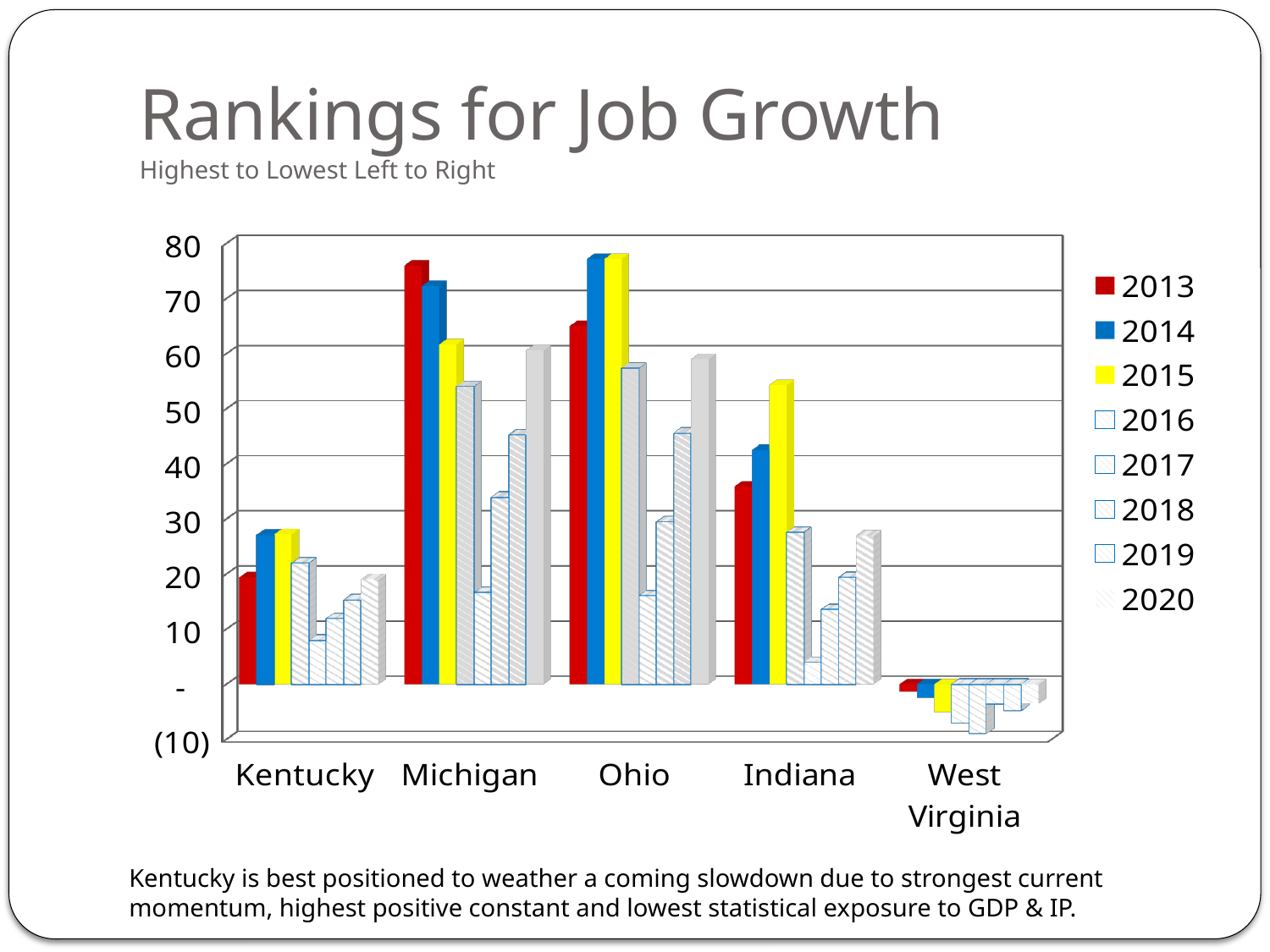
Is the value for Ohio in 2013 greater or less than 60? greater Is the value for Indiana in 2016 greater or less than 10? greater How many series does the chart's legend list? 8 Which is larger, the 2015 value for Ohio or the 2015 value for Indiana? Ohio What is the title of the chart on the slide? Rankings for Job Growth Do Michigan's values rise or fall from 2013 to 2017? fall How many states are shown on the x axis of the chart? 5 Which state has the highest value for 2013? Michigan What kind of chart is shown on the slide? bar chart Is the value for Michigan in 2013 greater or less than 70? greater Which state has the lowest value for 2015? West Virginia